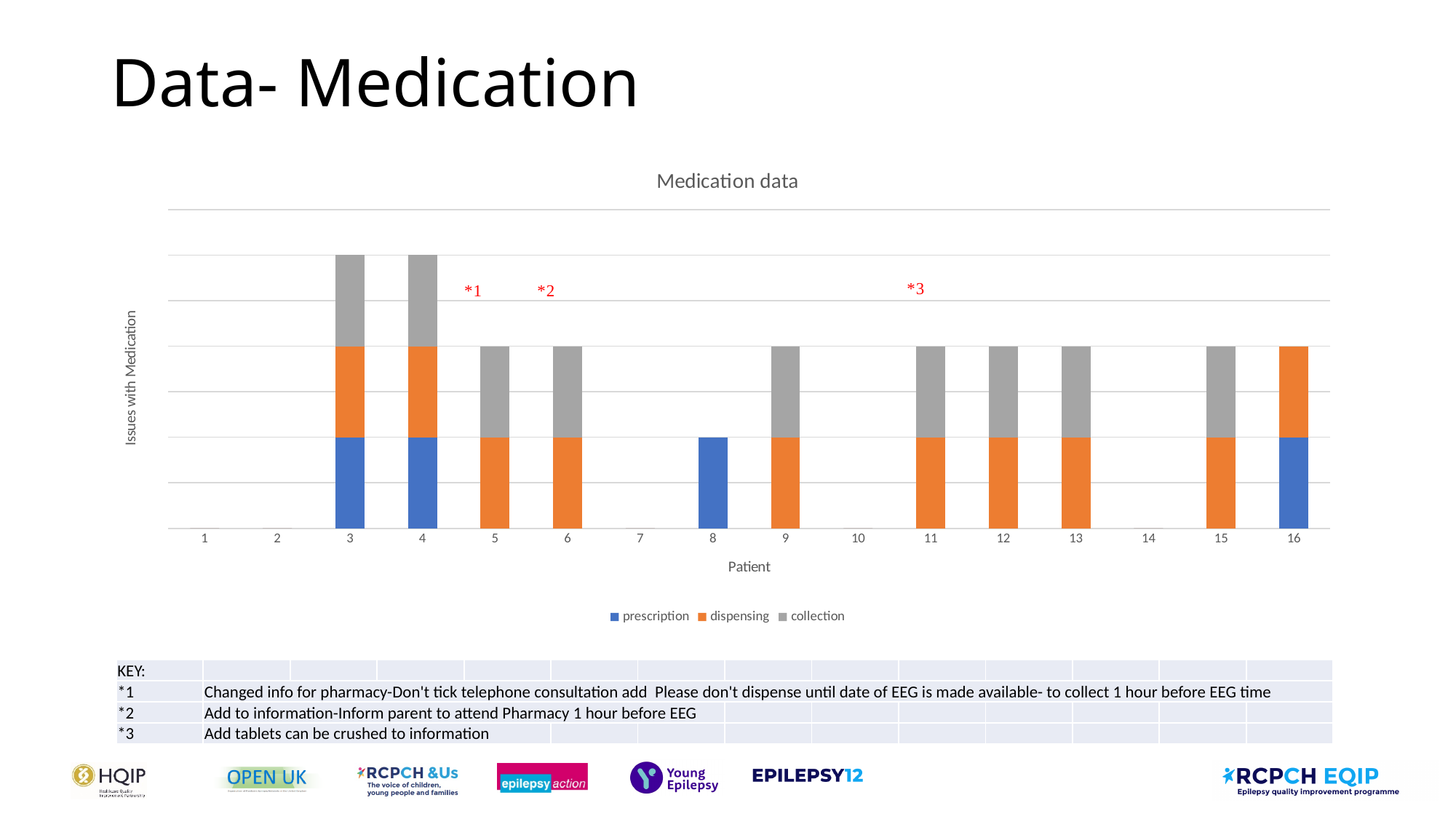
What kind of chart is shown on the slide? Stacked bar chart What is the title of the chart? Medication data Which patients have all three segments (prescription, dispensing and collection) in their bar? 3 and 4 Which patients have the tallest stacked bars? 3 and 4 Which series is shown in grey in the legend? collection Which patients have a prescription (blue) segment in their bar? 3, 4, 8 and 16 Is the bar for patient 3 taller or shorter than the bar for patient 5? Taller How many patients are shown along the x axis? 16 Which patient's bar consists only of a prescription segment? 8 How many series does the legend list? 3 Is the bar for patient 9 taller or shorter than the bar for patient 8? Taller How many patients have no bar at all? 5